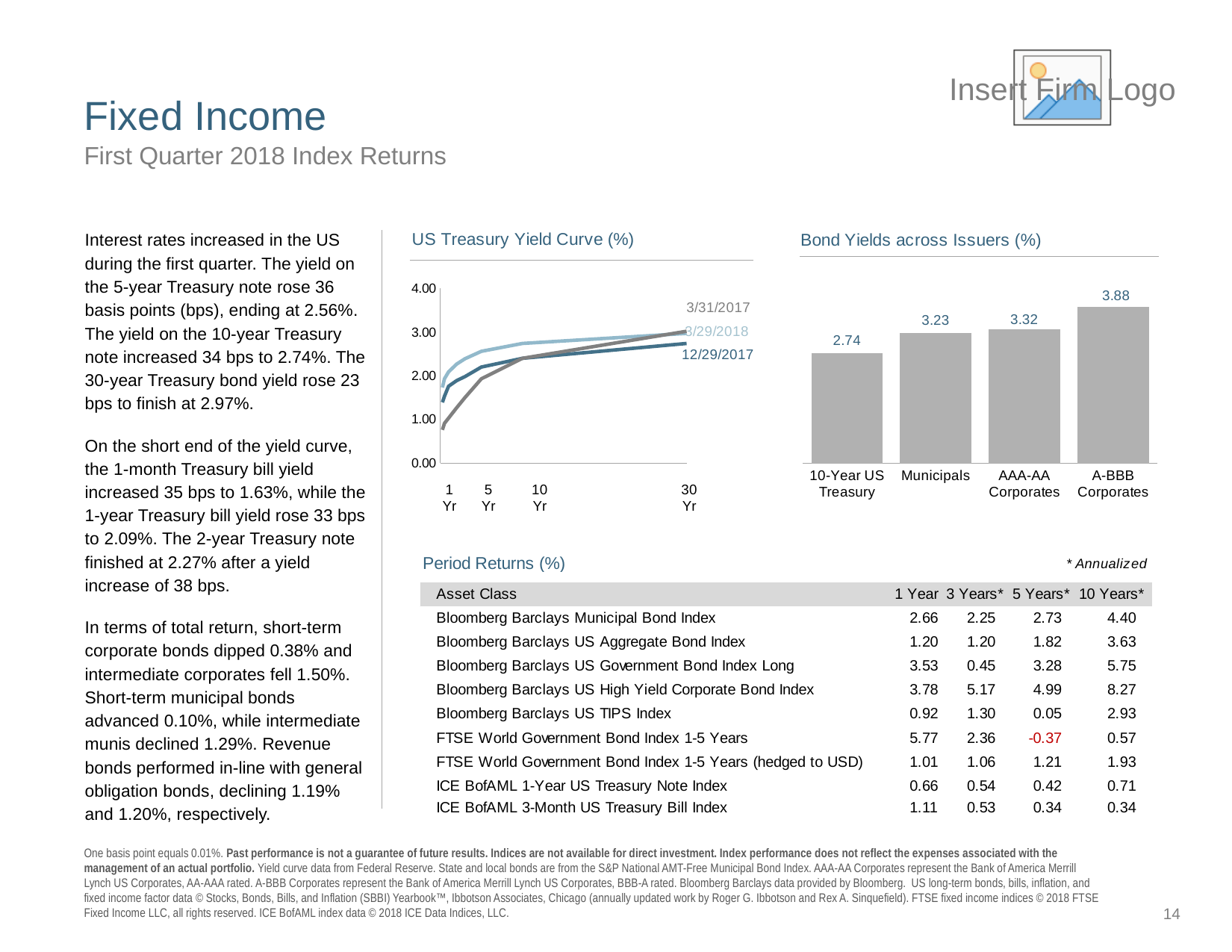
In the Bond Yields across Issuers chart, which issuer has the highest yield? A-BBB Corporates In the Bond Yields across Issuers chart, which issuer has the lowest yield? 10-Year US Treasury In the Bond Yields across Issuers chart, what is the difference between the yields of A-BBB Corporates and the 10-Year US Treasury? 1.14 What kind of chart is the Bond Yields across Issuers chart? Bar chart How many series are shown in the US Treasury Yield Curve chart? 3 What kind of chart is the US Treasury Yield Curve chart? Line chart In the Bond Yields across Issuers chart, which is larger, the yield for Municipals or for AAA-AA Corporates? AAA-AA Corporates In the Bond Yields across Issuers chart, what is the yield for A-BBB Corporates? 3.88 In the Bond Yields across Issuers chart, what is the yield for Municipals? 3.23 In the US Treasury Yield Curve chart, do the yields rise or fall as maturity increases from 1 Yr to 30 Yr? Rise How many issuer categories are shown in the Bond Yields across Issuers chart? 4